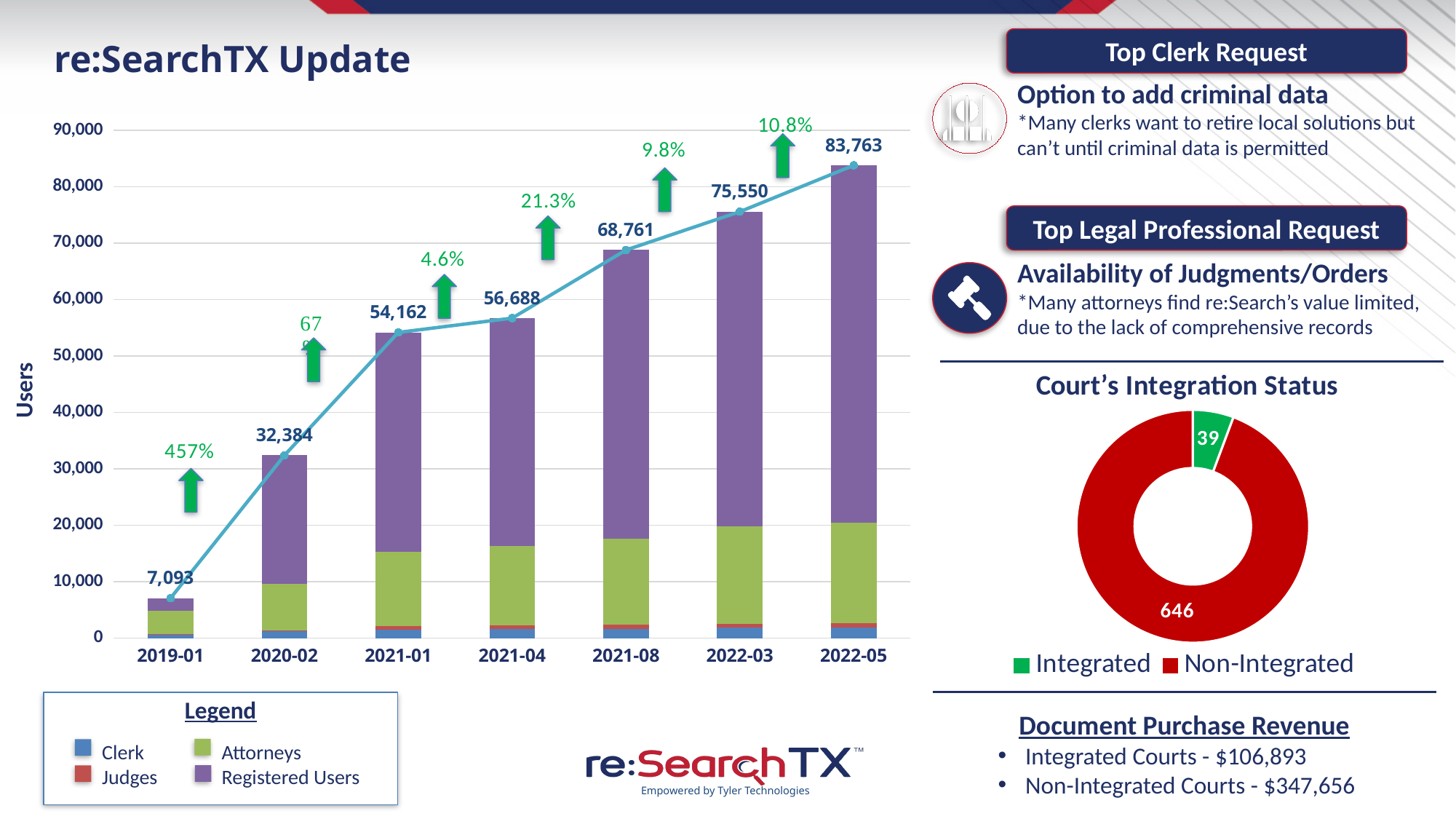
In the users bar chart, which period has the highest total number of users? 2022-05 How many series does the legend of the users bar chart list? 4 In the users bar chart, which period has the lowest total number of users? 2019-01 In the users bar chart, do the total users rise or fall from 2019-01 to 2022-05? rise In the users bar chart, what is the difference between the total users in 2022-05 and 2022-03? 8,213 In the users bar chart, how many time periods are shown on the x axis? 7 In the users bar chart, which is larger: the total users in 2021-04 or in 2021-01? 2021-04 In the users bar chart, what growth percentage is shown above the 2021-04 bar? 21.3% In the Court's Integration Status chart, how many courts are Non-Integrated? 646 What kind of chart is the Court's Integration Status chart? donut (pie) chart In the users bar chart, what is the total number of users labelled for 2022-05? 83,763 In the users bar chart, what is the total number of users labelled for 2019-01? 7,093